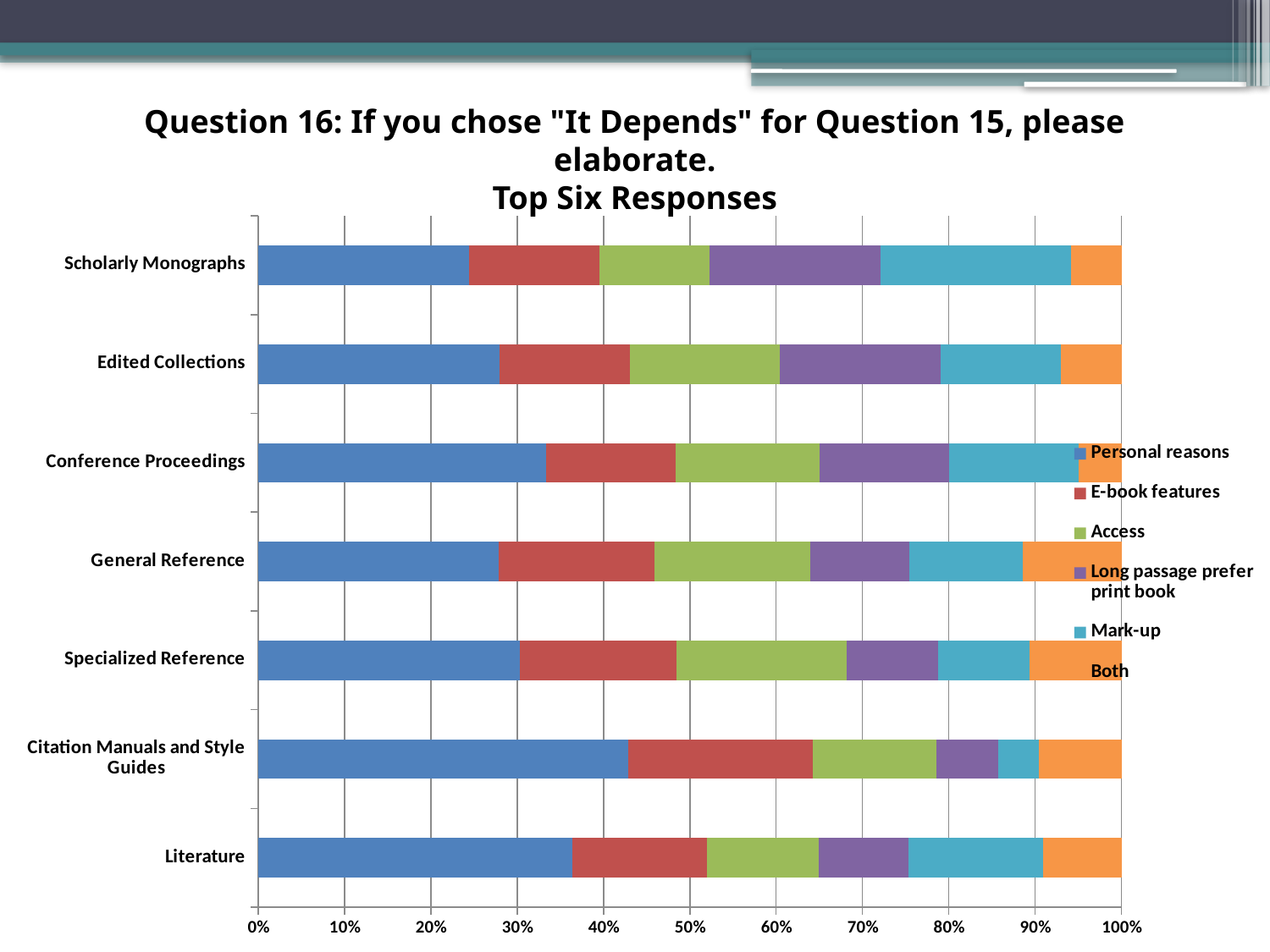
What kind of chart is shown on the slide? Stacked bar chart Is the Personal reasons share for Scholarly Monographs greater or less than 30%? less Is the Personal reasons share for Citation Manuals and Style Guides greater or less than 40%? greater What is the first series listed in the legend? Personal reasons What colour represents the Both series? Orange Which has the larger Long passage prefer print book share, Scholarly Monographs or Citation Manuals and Style Guides? Scholarly Monographs Is the Personal reasons share for Literature greater or less than 30%? greater How many categories (book types) are plotted on the chart? 7 Which category has the largest Personal reasons share? Citation Manuals and Style Guides Which has the larger Personal reasons share, Literature or Scholarly Monographs? Literature How many series does the legend list? 6 Which category has the smallest Personal reasons share? Scholarly Monographs